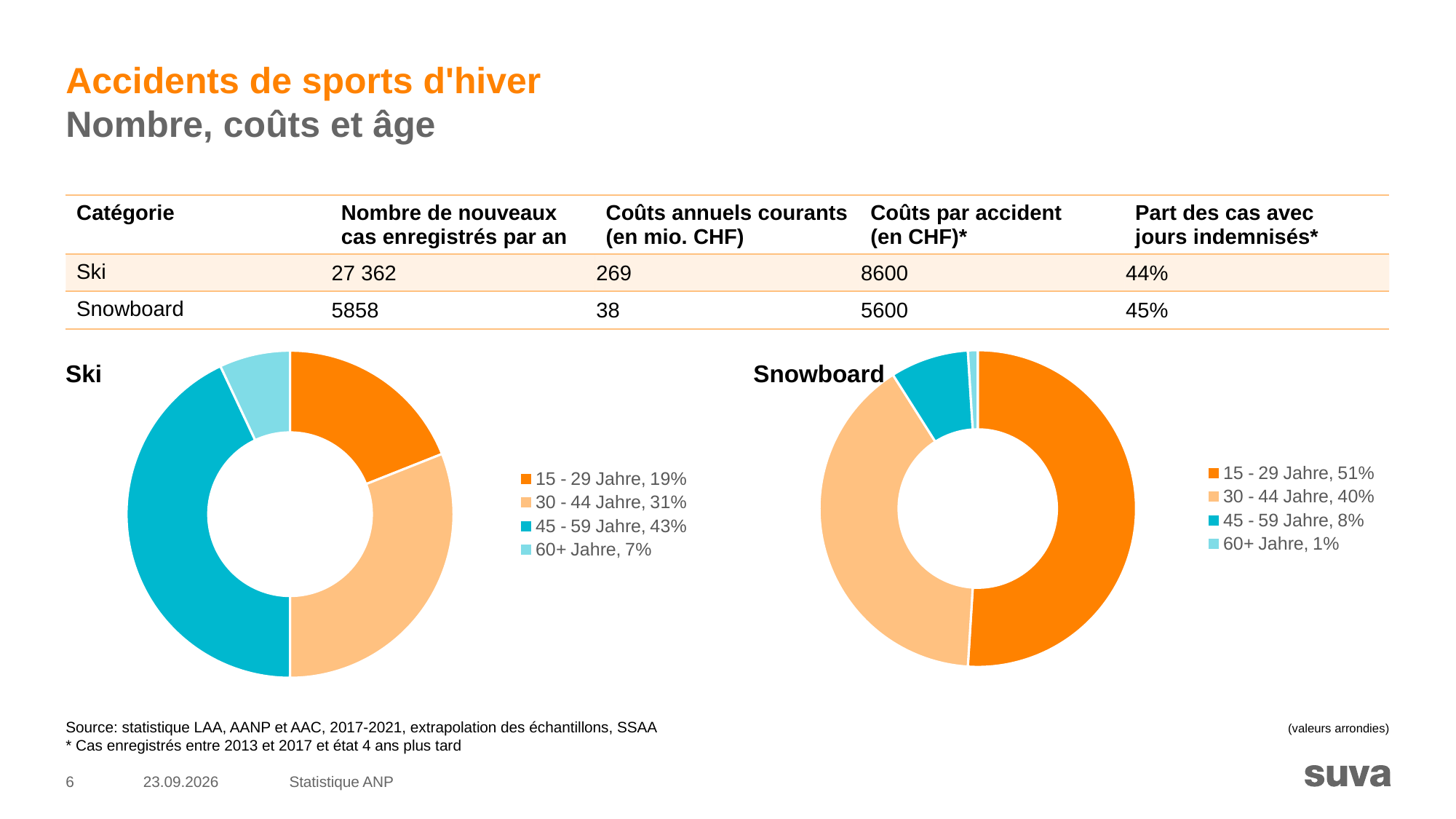
In the Snowboard chart, what share of accidents is in the 15 - 29 Jahre age group? 51% Which chart has the larger share for the 15 - 29 Jahre group, Ski or Snowboard? Snowboard What kind of chart is used for the Snowboard age distribution? Pie chart (donut) In the Ski chart, what is the difference in percentage points between the 45 - 59 Jahre and 15 - 29 Jahre shares? 24 In the Snowboard chart, what is the difference in percentage points between the 15 - 29 Jahre and 30 - 44 Jahre shares? 11 In the Snowboard chart, what is the share for the 30 - 44 Jahre group? 40% In the Ski chart, which age group has the largest share? 45 - 59 Jahre In the Ski chart, which colour represents the 30 - 44 Jahre group? Light orange In the Ski chart, what share of accidents is in the 45 - 59 Jahre age group? 43% In the Ski chart, what is the share for the 60+ Jahre group? 7% How many age groups does the legend of the Ski chart list? 4 In the Snowboard chart, which age group has the smallest share? 60+ Jahre